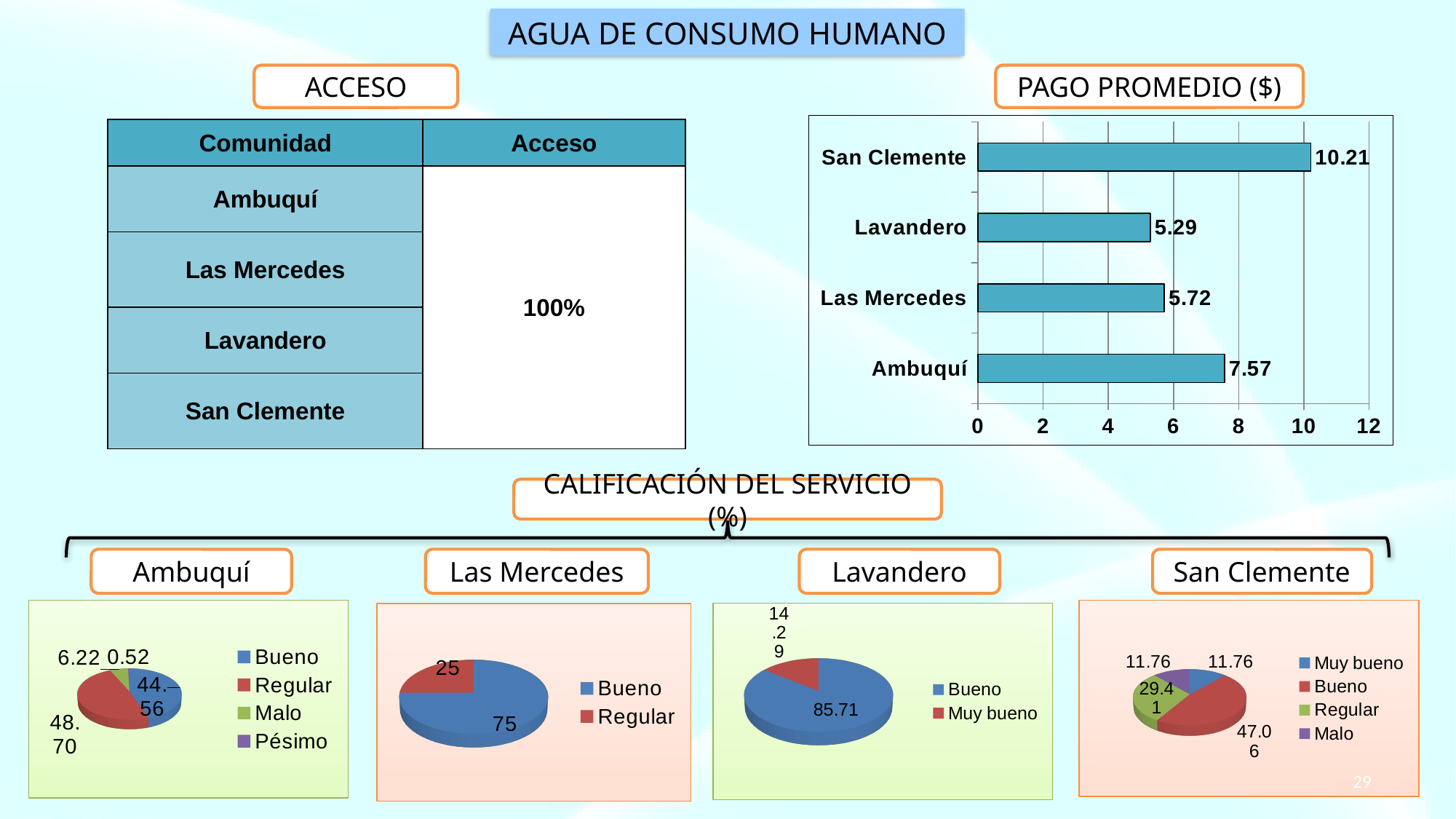
In the Ambuquí pie chart, which category has the smallest share? Pésimo How many communities are shown in the PAGO PROMEDIO ($) bar chart? 4 In the Las Mercedes pie chart, what share is labelled Bueno? 75 In the Lavandero pie chart, what share is labelled Bueno? 85.71 In the PAGO PROMEDIO ($) bar chart, which community has the highest average payment? San Clemente In the PAGO PROMEDIO ($) bar chart, what is the value for San Clemente? 10.21 In the PAGO PROMEDIO ($) bar chart, what is the value for Lavandero? 5.29 In the PAGO PROMEDIO ($) bar chart, which is larger, the value for Ambuquí or the value for Las Mercedes? Ambuquí How many series does the legend of the San Clemente pie chart list? 4 What kind of chart is the PAGO PROMEDIO ($) chart? Bar chart In the PAGO PROMEDIO ($) bar chart, what is the difference between the values for San Clemente and Ambuquí? 2.64 In the PAGO PROMEDIO ($) bar chart, which community has the lowest average payment? Lavandero